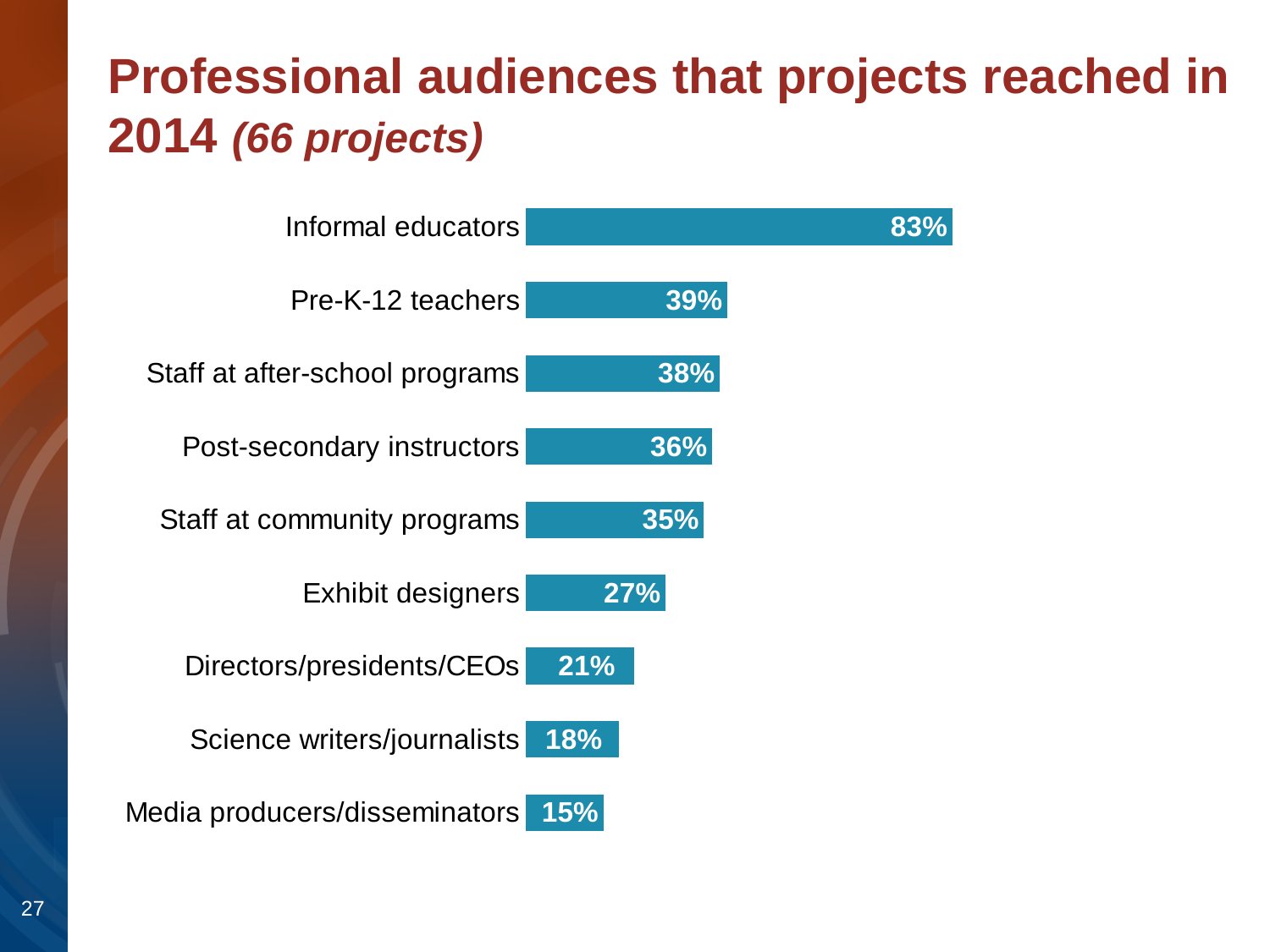
How many projects does the chart title say the data covers? 66 projects What is the difference between the values for informal educators and Pre-K-12 teachers? 44% What is the difference between the values for exhibit designers and directors/presidents/CEOs? 6% What percentage of projects reached informal educators? 83% Do the values rise or fall going from the top bar to the bottom bar? Fall Which is larger, the value for staff at community programs or the value for exhibit designers? Staff at community programs How many professional audience categories are shown in the chart? 9 What kind of chart is shown on the slide? Bar chart What percentage of projects reached science writers/journalists? 18% What is the value for Pre-K-12 teachers? 39% Which professional audience was reached by the lowest percentage of projects? Media producers/disseminators Which professional audience was reached by the highest percentage of projects? Informal educators